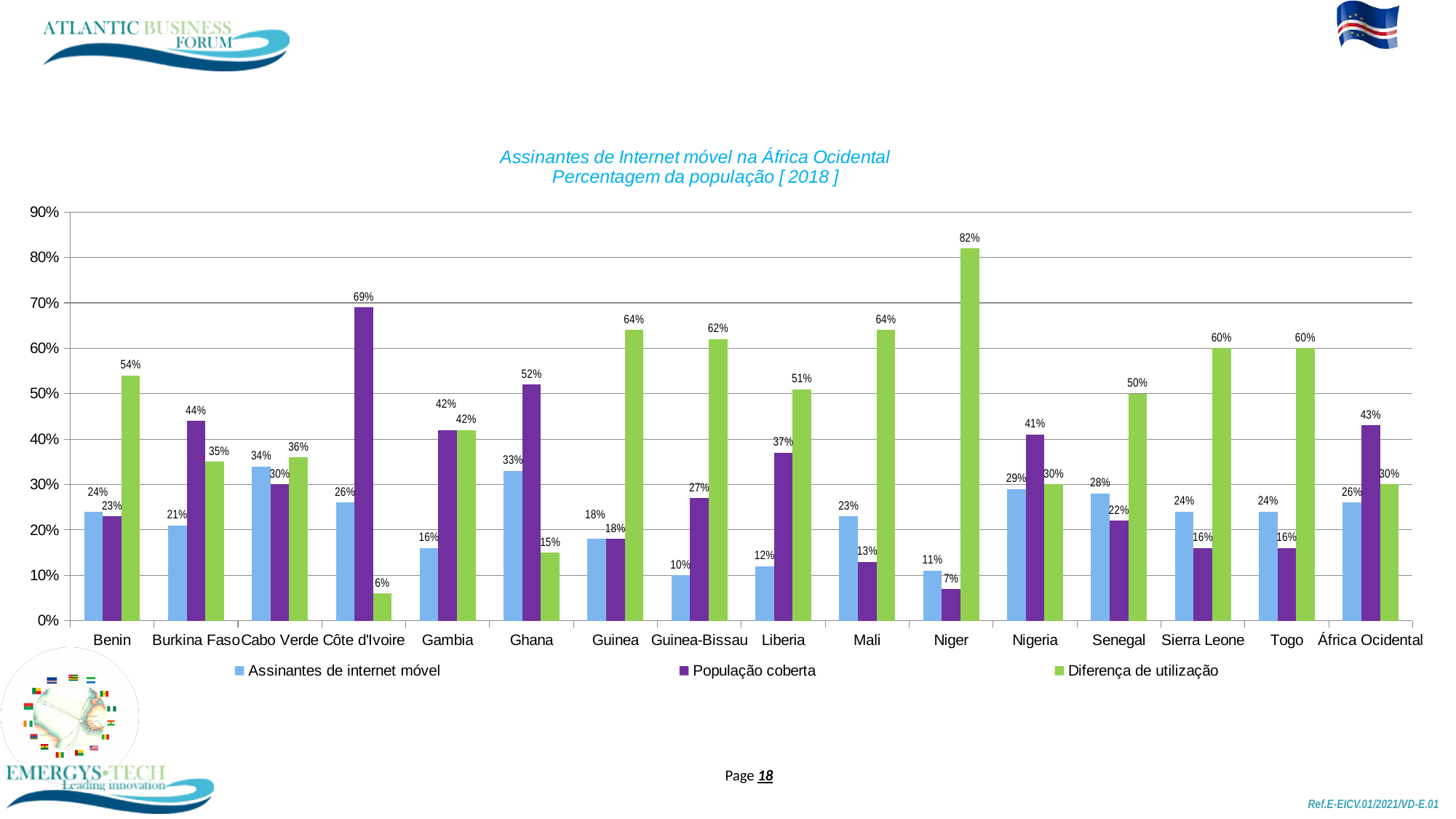
What year is given in the chart title? 2018 Which country has the lowest value for Assinantes de internet móvel? Guinea-Bissau How many series does the legend list? 3 Which country has the lowest Diferença de utilização? Côte d'Ivoire What is the value of População coberta for Côte d'Ivoire? 69% Which country has the highest Diferença de utilização? Niger What is the difference between the Diferença de utilização for Niger and for Benin? 28% What is the value of Diferença de utilização for Liberia? 51% What kind of chart is shown on the slide? Bar chart What is the value of Assinantes de internet móvel for Cabo Verde? 34% Which is larger for Ghana: Assinantes de internet móvel or População coberta? População coberta How many countries or regions are shown on the x axis? 16